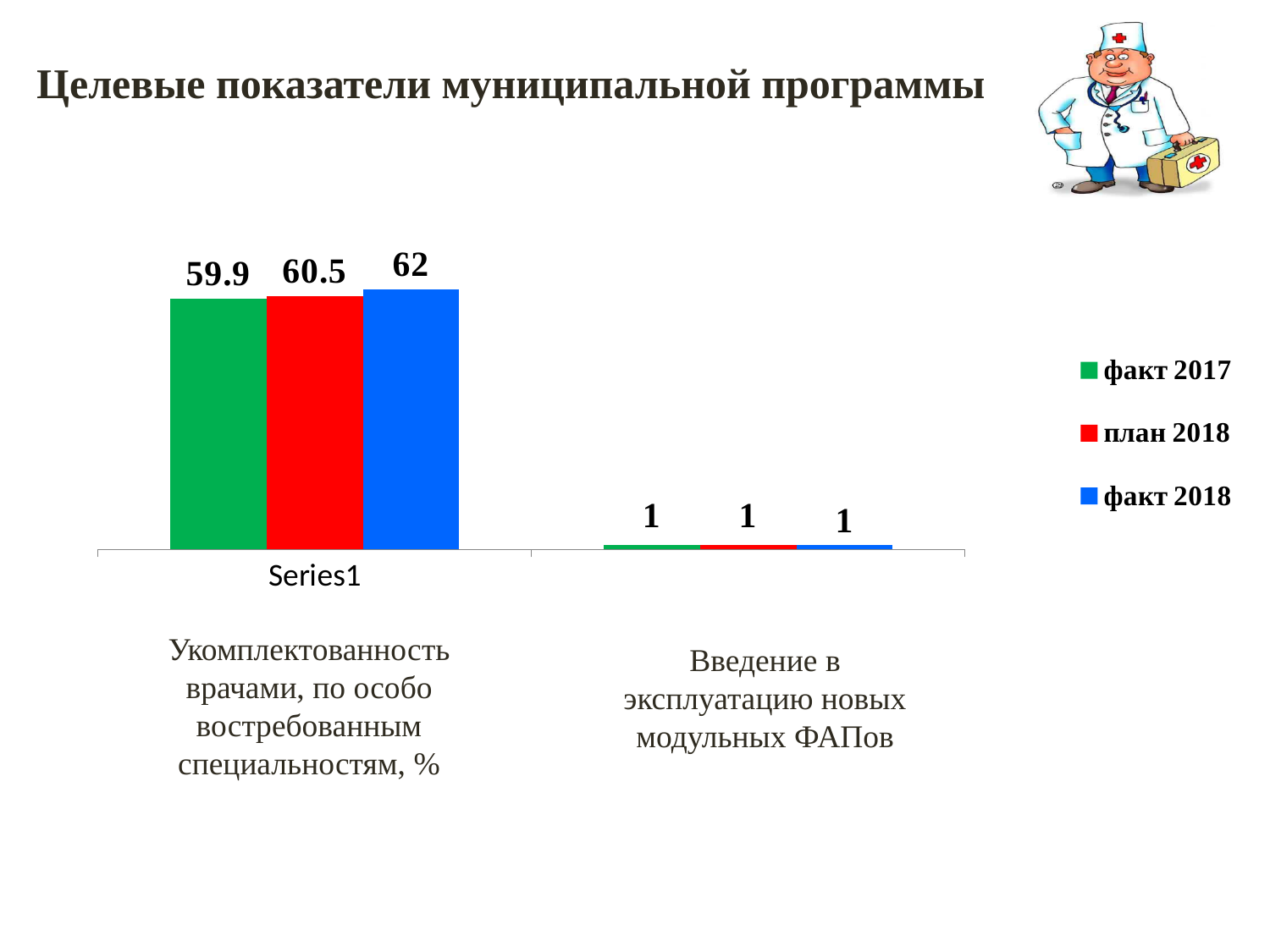
Which series has the highest value for Укомплектованность врачами, по особо востребованным специальностям, %? факт 2018 How many series does the legend list? 3 Which is larger for Укомплектованность врачами, по особо востребованным специальностям, %: план 2018 or факт 2018? факт 2018 What kind of chart is shown on the slide? bar chart What is the value of факт 2018 for Укомплектованность врачами, по особо востребованным специальностям, %? 62 What is the value of факт 2017 for Укомплектованность врачами, по особо востребованным специальностям, %? 59.9 What is the difference between факт 2018 and факт 2017 for Укомплектованность врачами, по особо востребованным специальностям, %? 2.1 What is the value of план 2018 for Укомплектованность врачами, по особо востребованным специальностям, %? 60.5 What is the title of the slide? Целевые показатели муниципальной программы Which series has the lowest value for Укомплектованность врачами, по особо востребованным специальностям, %? факт 2017 What is the value of факт 2018 for Введение в эксплуатацию новых модульных ФАПов? 1 Which legend entry is shown in red? план 2018